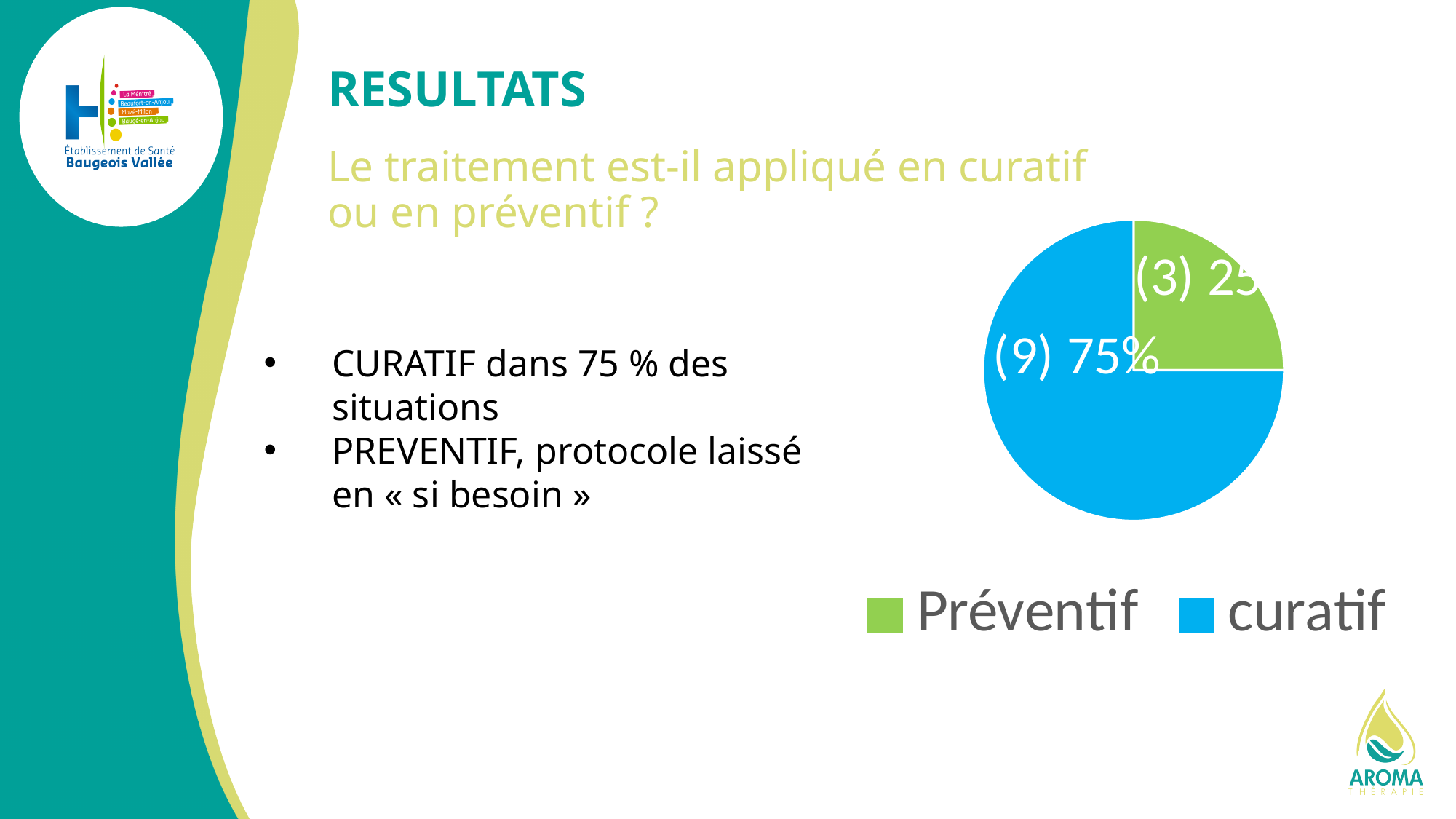
What share of the pie does the Préventif slice represent? 25% What colour is the curatif slice in the pie chart? blue What percentage of the pie chart does the curatif slice represent? 75% Which category has the smallest slice in the pie chart? Préventif What is the difference between the counts for curatif and Préventif? 6 How many slices does the pie chart have? 2 What count is shown in parentheses for the Préventif slice? 3 Which is larger in the pie chart, the curatif slice or the Préventif slice? curatif How many entries does the legend of the pie chart list? 2 Which category has the largest slice in the pie chart? curatif What kind of chart is shown on the slide? pie chart What count is shown in parentheses for the curatif slice? 9